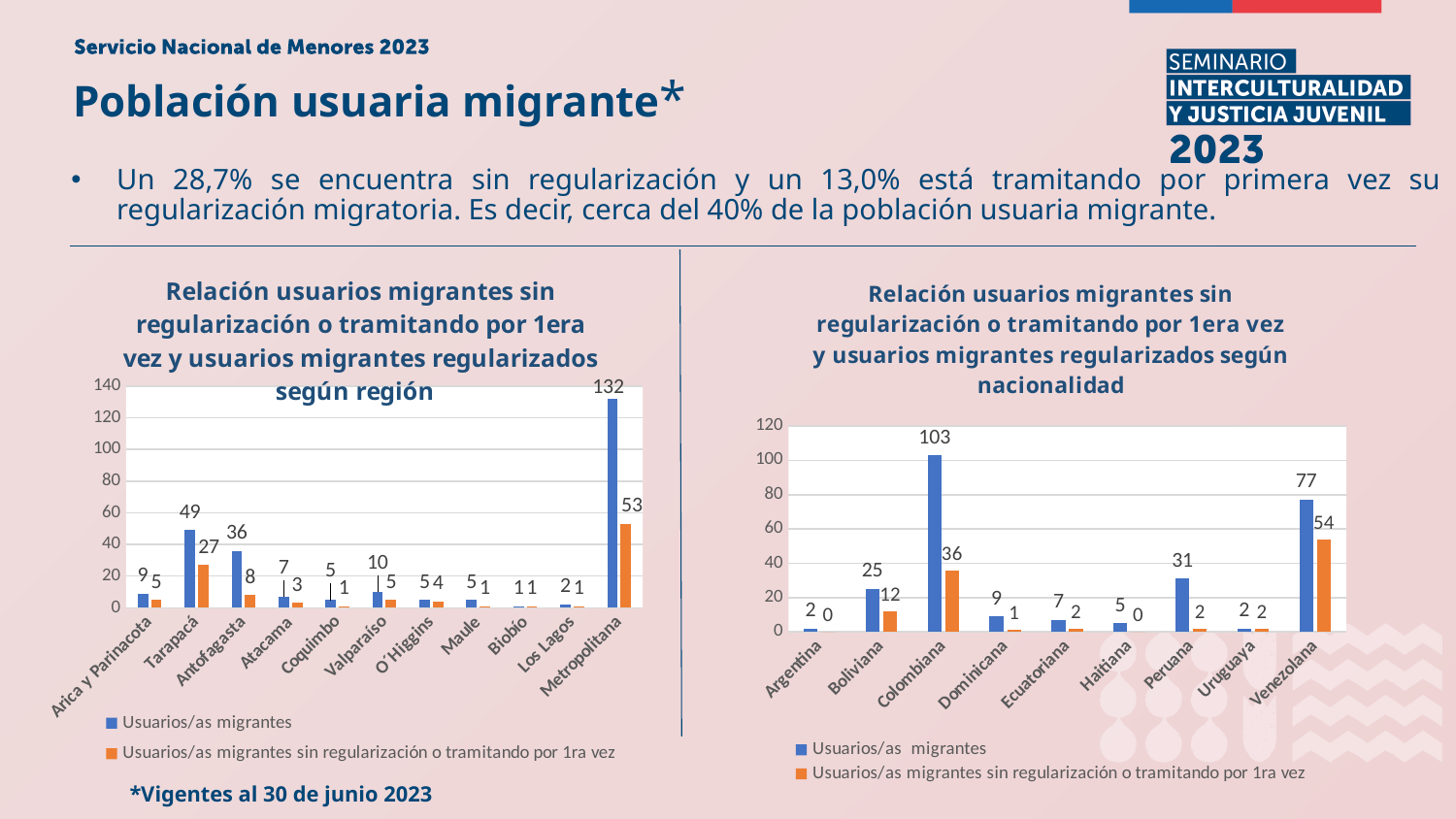
In the chart by región (left), what is the difference between Usuarios/as migrantes and Usuarios/as migrantes sin regularización o tramitando por 1ra vez for Antofagasta? 28 In the chart by región (left), what is the value of Usuarios/as migrantes for Metropolitana? 132 What type of chart is the chart by nacionalidad (right)? Bar chart In the chart by región (left), which region has the highest value of Usuarios/as migrantes? Metropolitana In the chart by nacionalidad (right), what is the value of Usuarios/as migrantes sin regularización o tramitando por 1ra vez for Venezolana? 54 In the chart by nacionalidad (right), what is the value of Usuarios/as migrantes for Colombiana? 103 In the chart by región (left), what is the value of Usuarios/as migrantes sin regularización o tramitando por 1ra vez for Tarapacá? 27 In the chart by región (left), how many regions are shown on the x axis? 11 In the chart by nacionalidad (right), which is larger: Usuarios/as migrantes for Boliviana or for Peruana? Peruana In the chart by nacionalidad (right), which nationality has the highest value of Usuarios/as migrantes sin regularización o tramitando por 1ra vez? Venezolana In the chart by nacionalidad (right), how many series does the legend list? 2 In the chart by nacionalidad (right), what is the difference between Usuarios/as migrantes for Colombiana and for Venezolana? 26